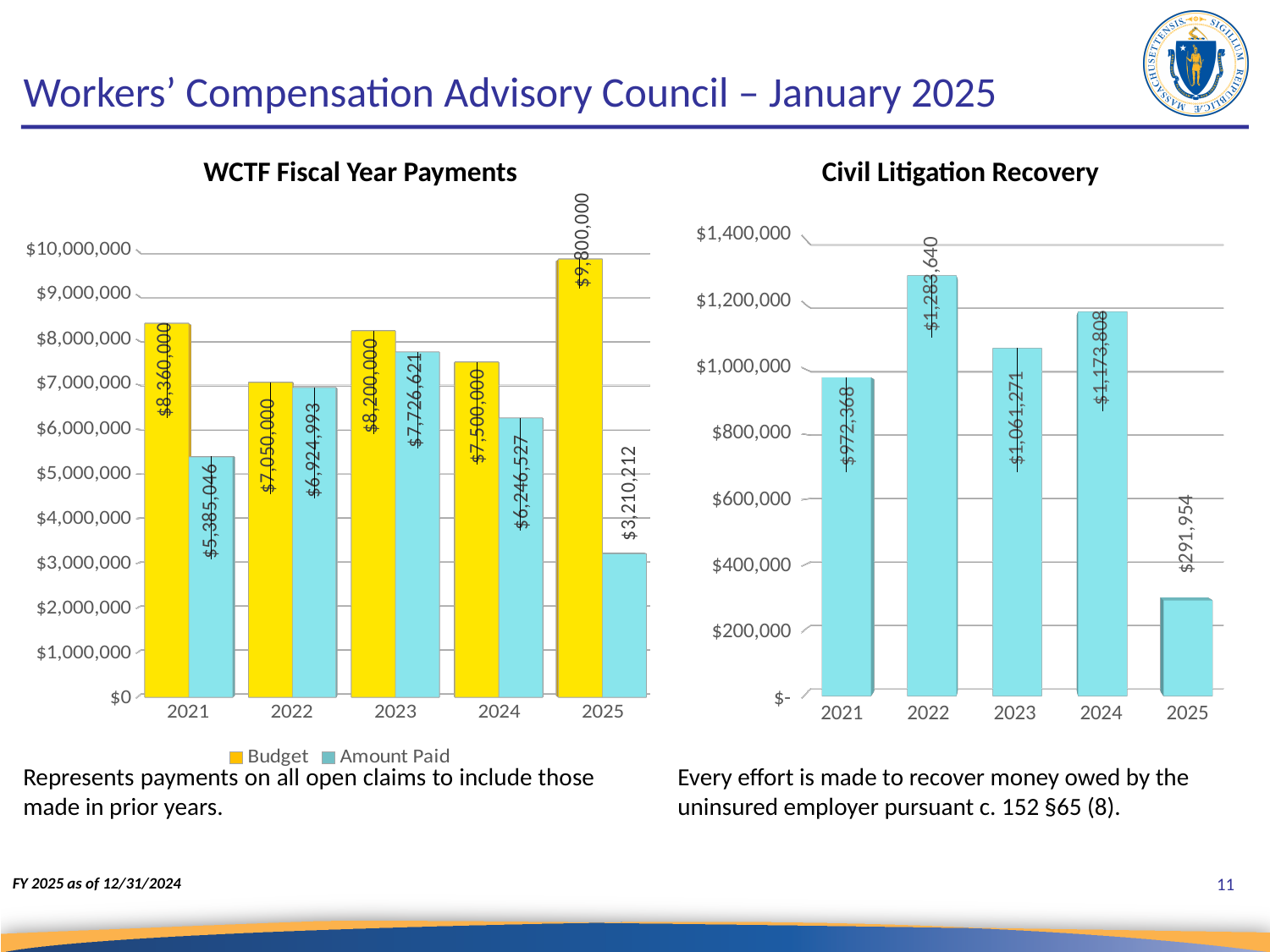
In the Civil Litigation Recovery chart, what is the difference between the 2024 and 2023 values? $112,537 In the WCTF Fiscal Year Payments chart, what is the Budget value for 2021? $8,360,000 In the Civil Litigation Recovery chart, which year has the highest value? 2022 How many years are shown on the x axis of the Civil Litigation Recovery chart? 5 In the WCTF Fiscal Year Payments chart, is the Budget value for 2025 greater or less than $9,000,000? greater In the Civil Litigation Recovery chart, what is the value for 2022? $1,283,640 In the WCTF Fiscal Year Payments chart, which year has the lowest Amount Paid? 2025 How many series does the legend of the WCTF Fiscal Year Payments chart list? 2 What kind of chart is the Civil Litigation Recovery chart? bar chart In the WCTF Fiscal Year Payments chart, what is the Amount Paid for 2023? $7,726,621 In the WCTF Fiscal Year Payments chart, what is the difference between the Budget and the Amount Paid for 2024? $1,253,473 In the WCTF Fiscal Year Payments chart, is the Amount Paid for 2022 greater or less than the Amount Paid for 2021? greater